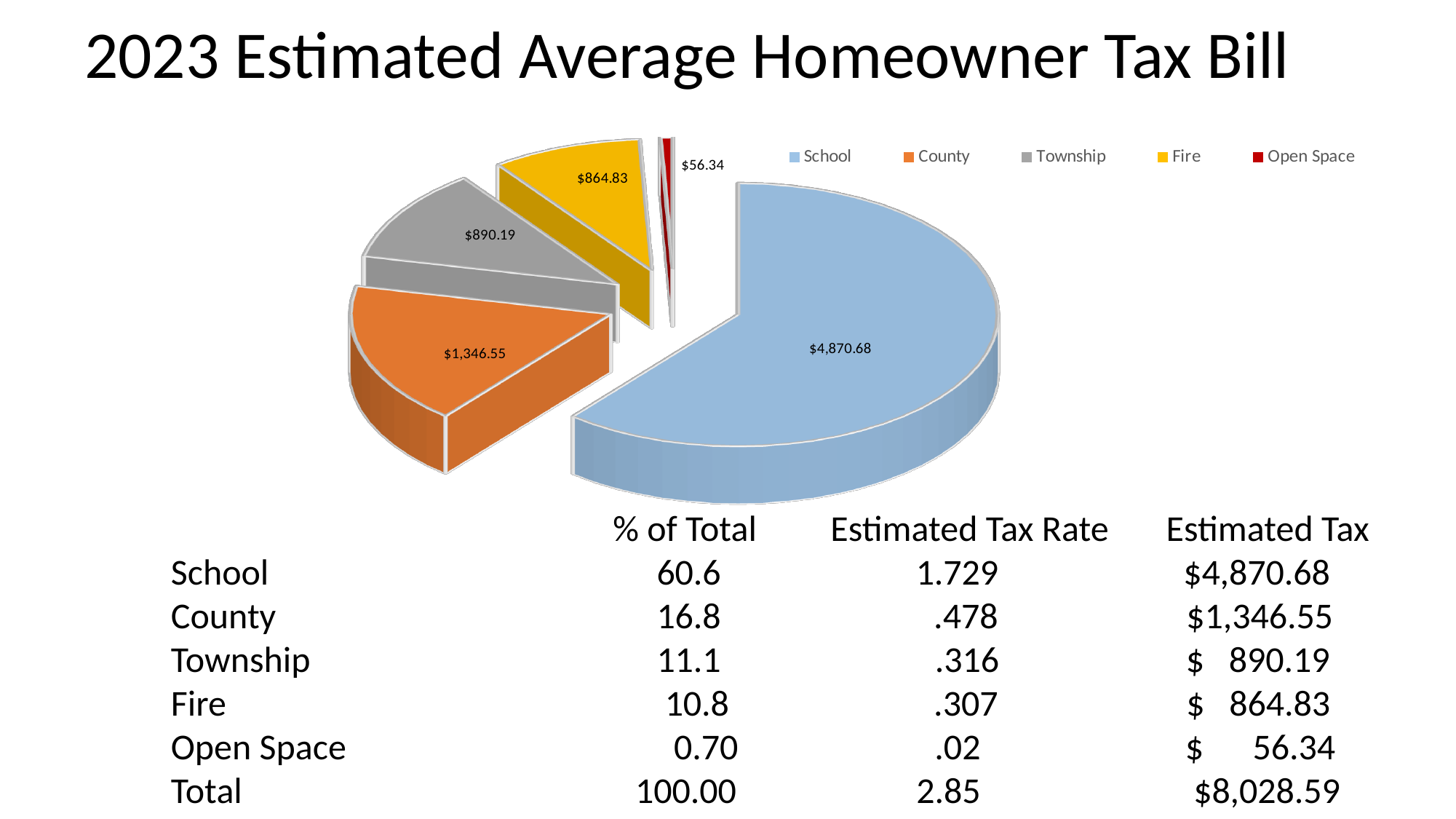
How many slices does the pie chart have? 5 What is the difference between the School and County amounts in the pie chart? $3,524.13 What type of chart is shown on the slide? Pie chart How many entries does the pie chart's legend list? 5 What is the difference between the Township and Fire amounts in the pie chart? $25.36 What is the estimated tax amount for the Open Space slice of the pie chart? $56.34 What share of the total does the School slice represent, according to the slide? 60.6% Which category has the smallest slice of the pie chart? Open Space Which is larger in the pie chart, the Township amount or the Fire amount? Township What is the estimated tax amount for the School slice of the pie chart? $4,870.68 Which category has the largest slice of the pie chart? School What is the estimated tax amount for the County slice of the pie chart? $1,346.55